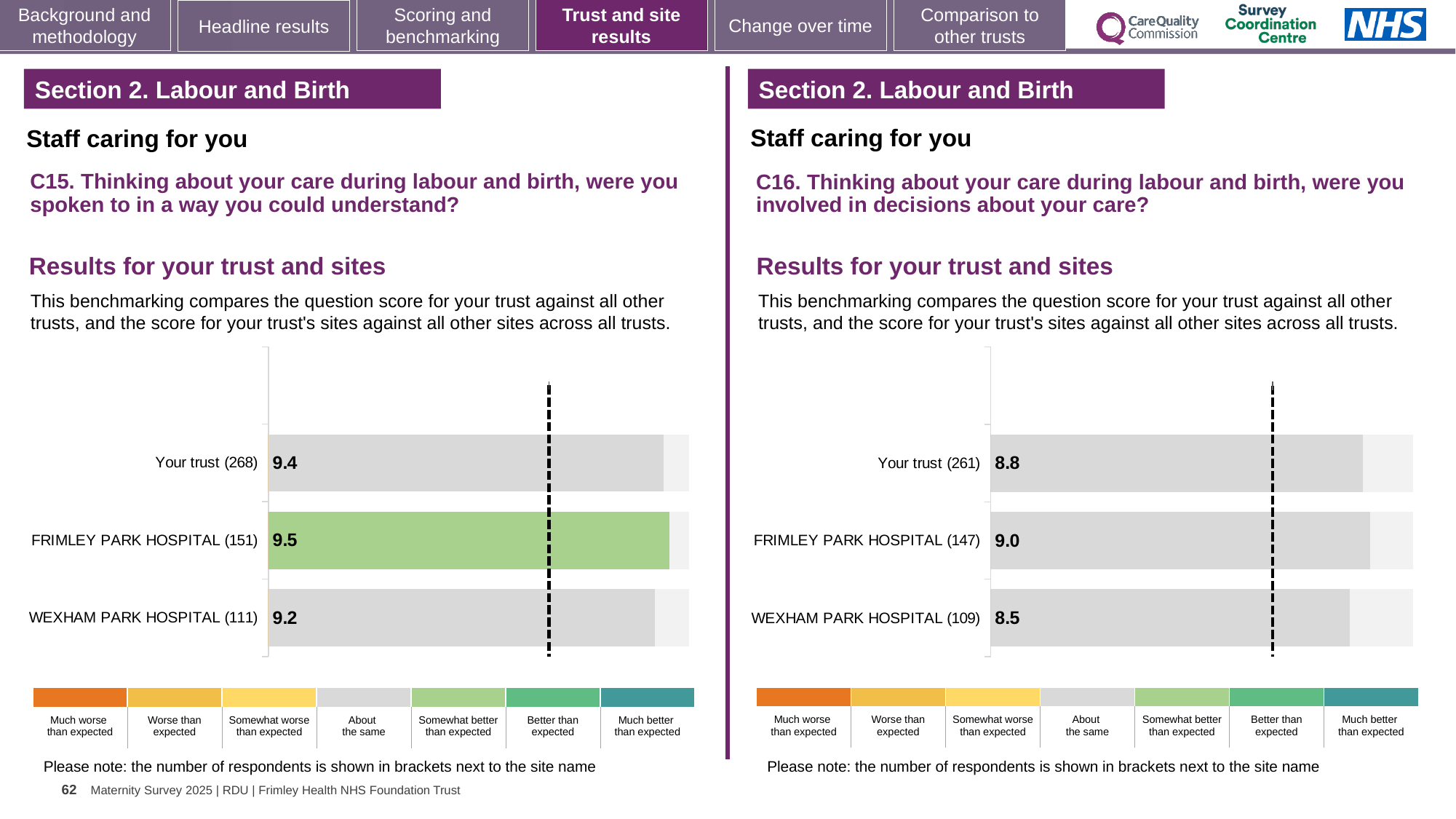
On the C15 chart (left), which has the larger score, Your trust or WEXHAM PARK HOSPITAL? Your trust On the C15 chart (left), what is the score for Your trust? 9.4 On the C16 chart (right), what is the score for WEXHAM PARK HOSPITAL? 8.5 How many bars are shown on the C16 chart (right)? 3 On the C16 chart (right), which site or trust has the highest score? FRIMLEY PARK HOSPITAL On the C15 chart (left), which site or trust has the lowest score? WEXHAM PARK HOSPITAL On the C15 chart (left), which bar is coloured green, indicating 'Somewhat better than expected'? FRIMLEY PARK HOSPITAL On the C15 chart (left), what is the score for FRIMLEY PARK HOSPITAL? 9.5 On the C16 chart (right), what is the difference between the scores for FRIMLEY PARK HOSPITAL and WEXHAM PARK HOSPITAL? 0.5 On the C16 chart (right), what is the score for Your trust? 8.8 On the C15 chart (left), what is the score for WEXHAM PARK HOSPITAL? 9.2 What type of chart is used on the C15 chart (left)? Bar chart